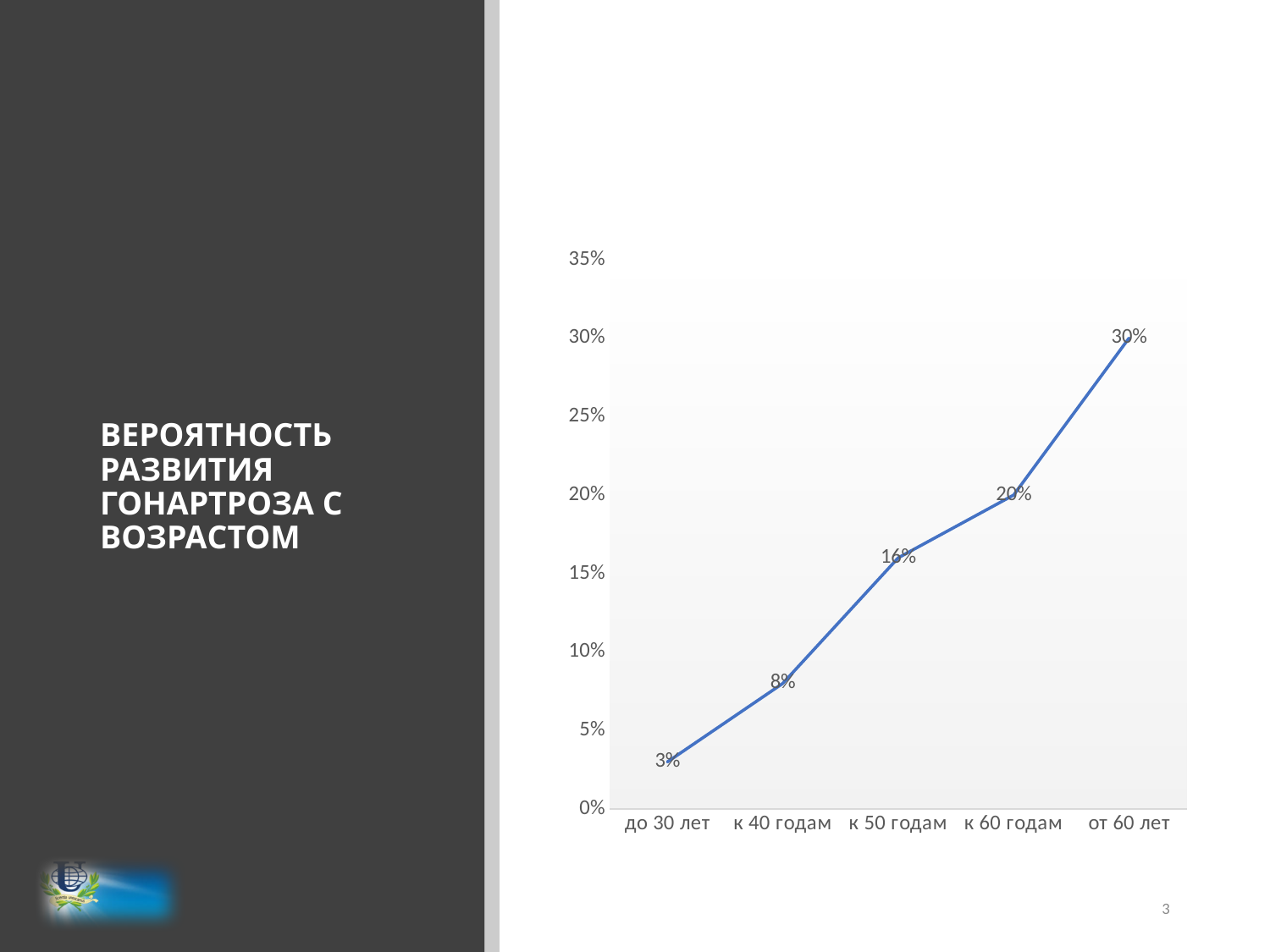
Which is larger, the value for "к 50 годам" or the value for "к 40 годам"? к 50 годам What is the value for "к 60 годам"? 20% What is the value for "до 30 лет"? 3% What is the difference between the values for "от 60 лет" and "к 60 годам"? 10% What is the value for "к 50 годам"? 16% Do the values rise or fall along the x axis from "до 30 лет" to "от 60 лет"? rise Which age category has the highest value? от 60 лет What is the value for "от 60 лет"? 30% Which age category has the lowest value? до 30 лет How many age categories are plotted on the x axis? 5 What is the value for "к 40 годам"? 8% What kind of chart is shown on the slide? line chart